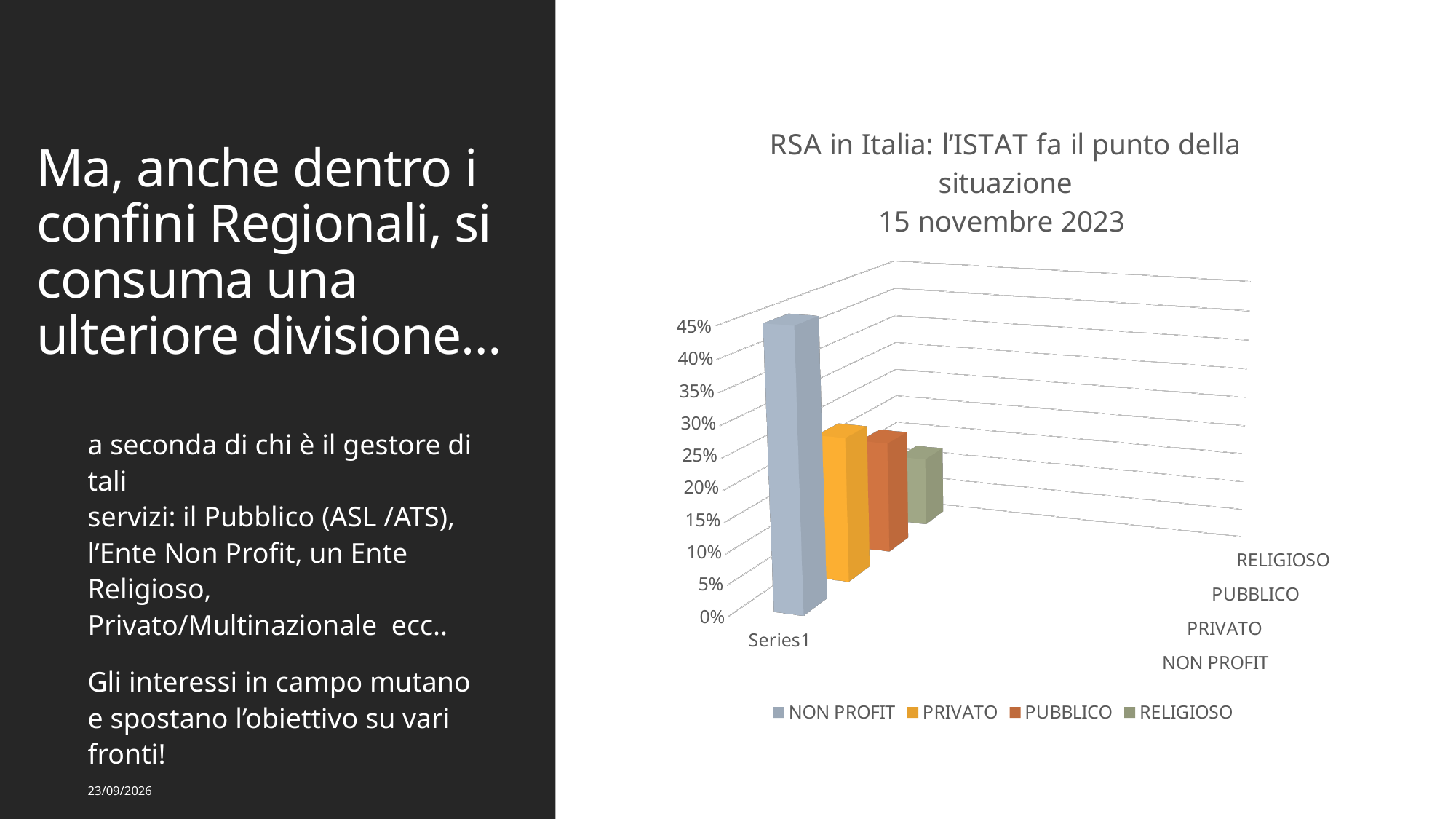
Which is larger, the value for NON PROFIT or the value for PUBBLICO? NON PROFIT How many bars are plotted in the chart? 4 How many series does the chart legend list? 4 What kind of chart is shown on the slide? bar chart Which category has the lowest value in the chart? RELIGIOSO Which category has the highest value in the chart? NON PROFIT Which is larger, the value for PRIVATO or the value for RELIGIOSO? PRIVATO Is the value for PRIVATO greater or less than 40%? less Is the value for NON PROFIT greater or less than 30%? greater What is the title of the chart? RSA in Italia: l'ISTAT fa il punto della situazione 15 novembre 2023 Which legend entry is shown in yellow? PRIVATO Is the value for RELIGIOSO greater or less than 30%? less